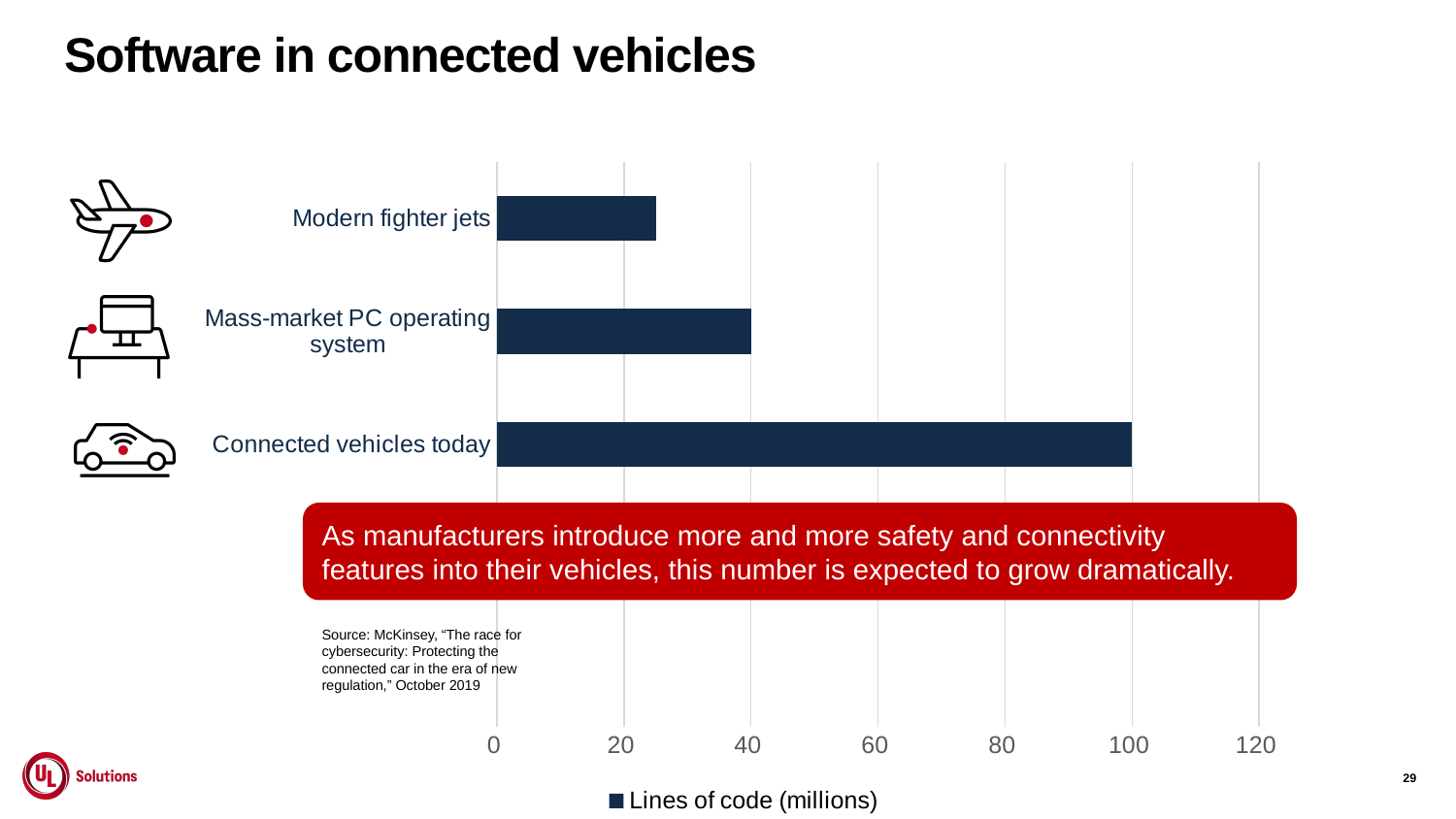
What kind of chart is shown on the slide? bar chart What series name does the legend show? Lines of code (millions) How many categories does the chart show? 3 What is the value for Connected vehicles today? 100 Which category has the lowest number of lines of code? Modern fighter jets Is the value for Modern fighter jets greater or less than 40? less Which has more lines of code, Mass-market PC operating system or Modern fighter jets? Mass-market PC operating system What is the value for Mass-market PC operating system? 40 Which category has the highest number of lines of code? Connected vehicles today How many series does the legend list? 1 Is the value for Modern fighter jets greater or less than 20? greater What is the difference between the values for Connected vehicles today and Mass-market PC operating system? 60